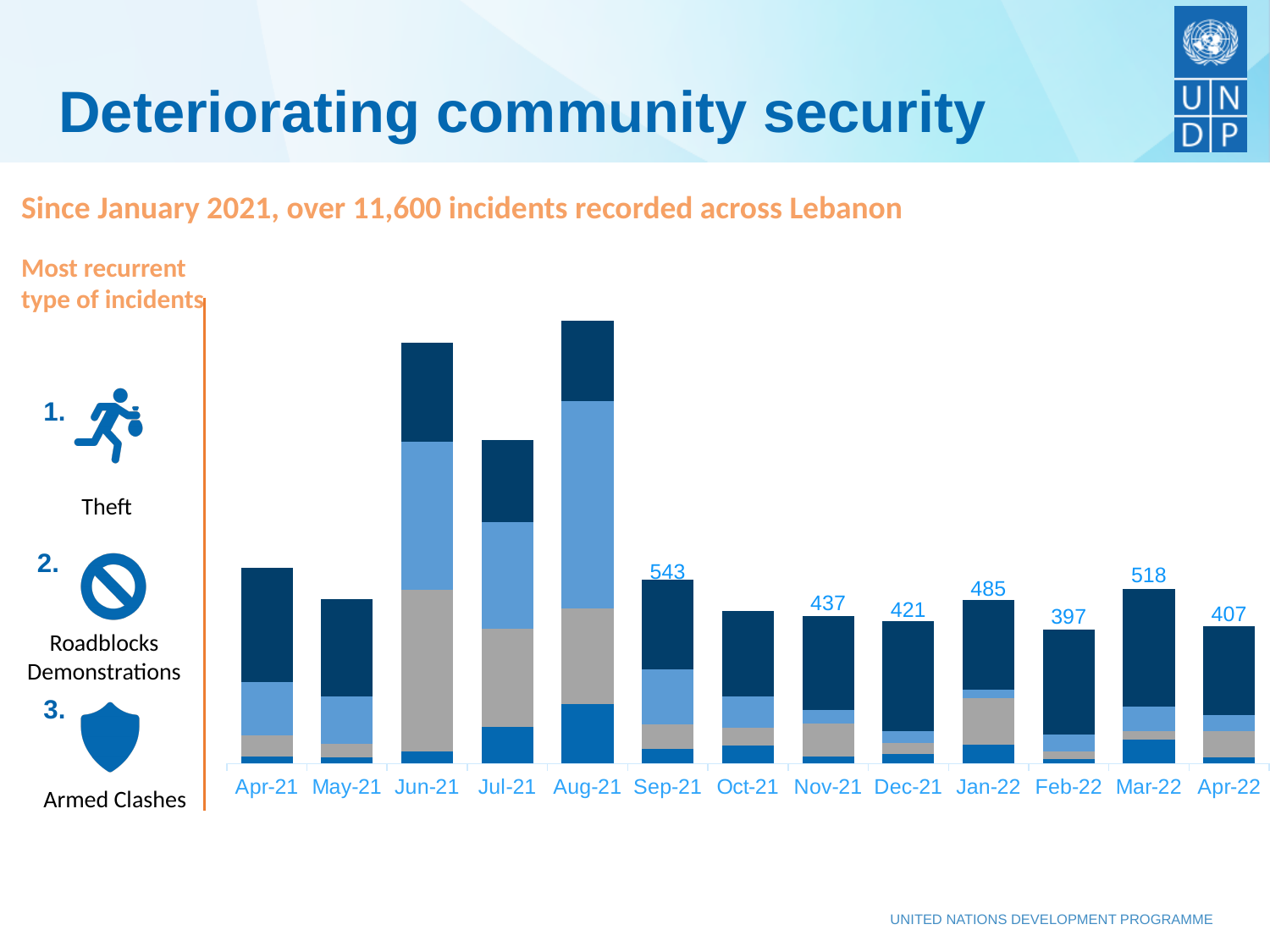
What is the total number of incidents labelled for Feb-22? 397 Which month has the larger total, Jan-22 or Dec-21? Jan-22 What is the difference between the totals for Mar-22 and Feb-22? 121 How many months are shown along the x axis of the chart? 13 Which month has the tallest bar in the chart? Aug-21 What kind of chart is shown on the slide? stacked bar chart What is the difference between the totals for Sep-21 and Apr-22? 136 What is the total number of incidents labelled for Mar-22? 518 What is the total number of incidents labelled for Sep-21? 543 Which month has the lowest total in the chart? Feb-22 What is the total number of incidents labelled for Jan-22? 485 Which month has the taller bar, Jun-21 or Jul-21? Jun-21